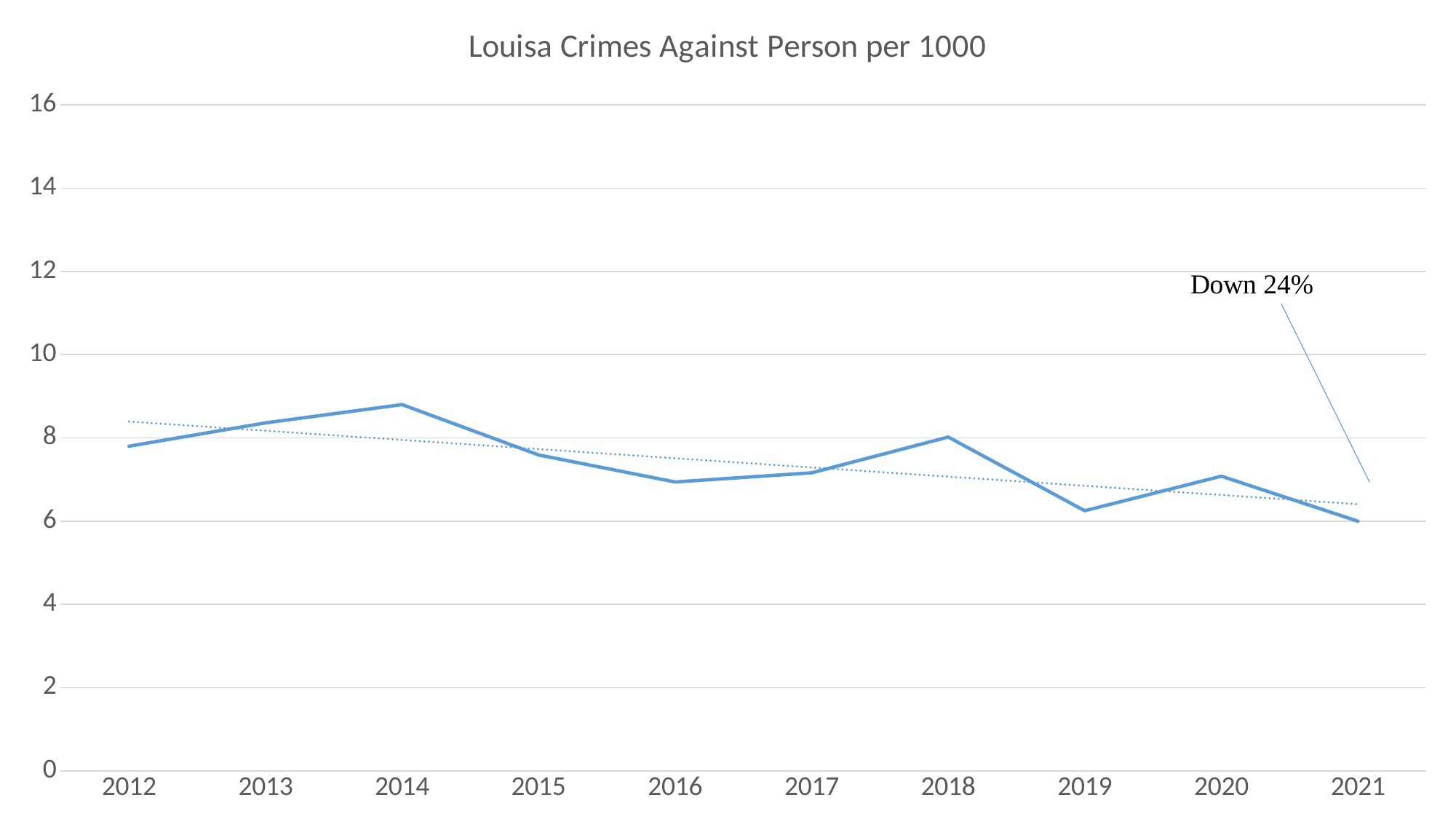
Which is larger, the value for 2014 or the value for 2019? 2014 Is the value for 2014 greater or less than 8? greater What kind of chart is shown on the slide? line chart Is the value for 2020 greater or less than 6? greater Is the value for 2019 greater or less than 8? less How many years are plotted along the x axis? 10 Which is larger, the value for 2018 or the value for 2016? 2018 What is the title of the chart? Louisa Crimes Against Person per 1000 Which year has the highest value? 2014 What does the annotation pointing to the end of the line say? Down 24% Overall, do the values rise or fall from 2012 to 2021? fall